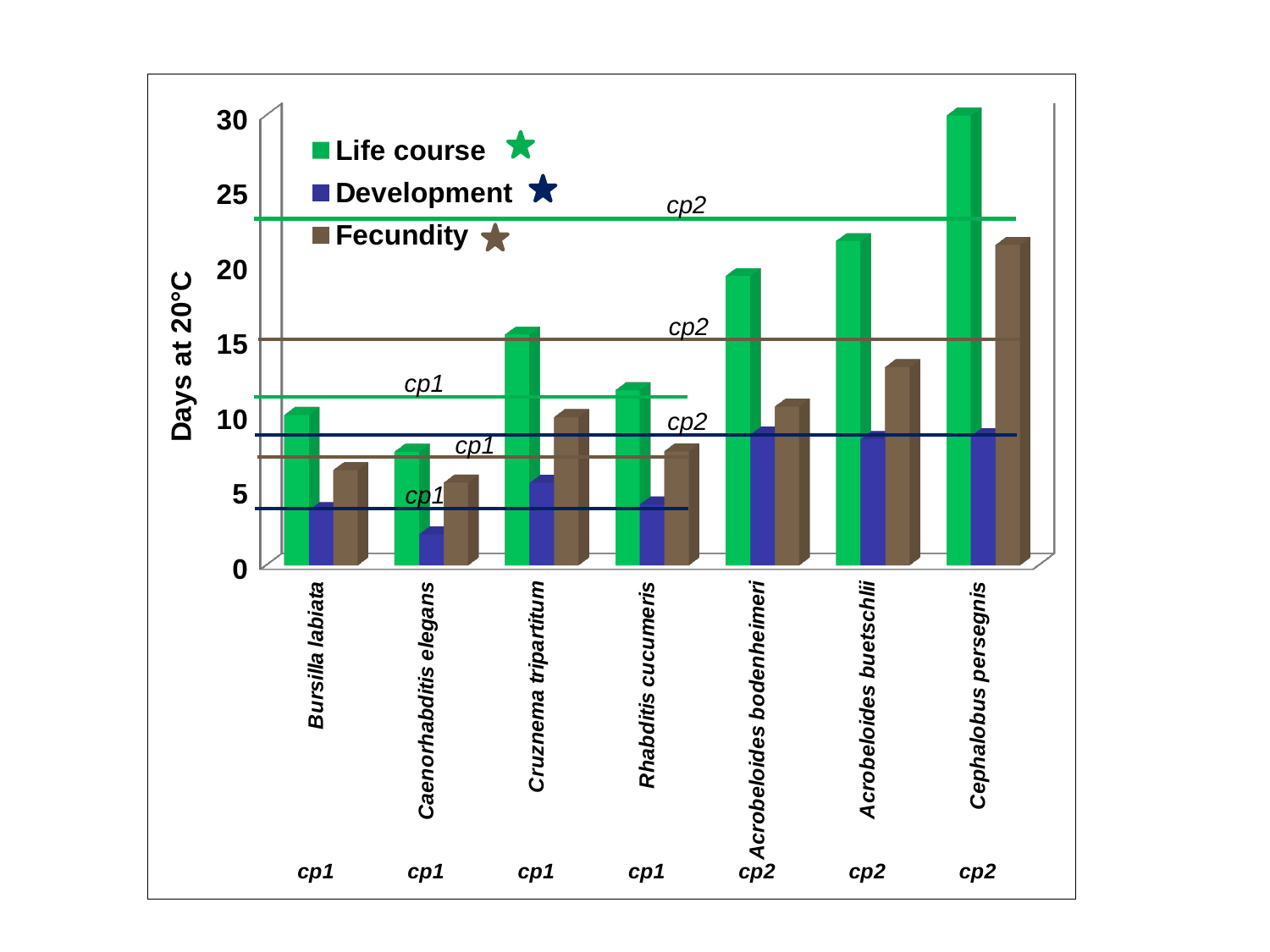
What kind of chart is shown on the slide? bar chart Is the Life course value for Acrobeloides bodenheimeri greater or less than 15? greater Which species has the lowest Life course value? Caenorhabditis elegans How many series does the legend list? 3 Which is larger, the Life course value for Cruznema tripartitum or for Rhabditis cucumeris? Cruznema tripartitum How many species are plotted along the x axis? 7 Which species has the highest Fecundity value? Cephalobus persegnis What is the label on the y axis? Days at 20°C Which species has the highest Life course value? Cephalobus persegnis Which species has the lowest Development value? Caenorhabditis elegans Is the Fecundity value for Caenorhabditis elegans greater or less than 10? less Do the Life course values generally rise or fall from left to right across the species? rise